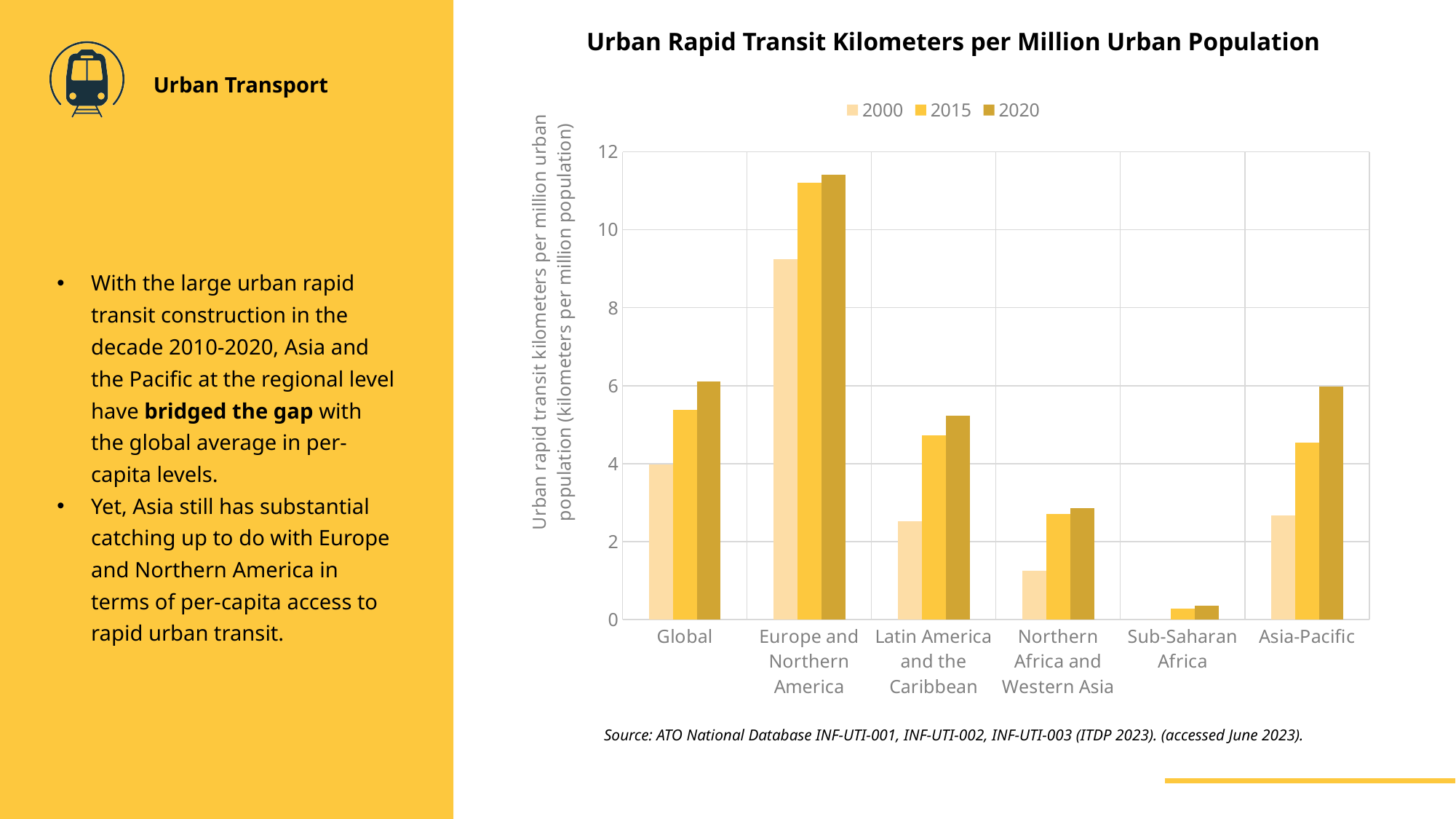
Which is larger in 2020: Asia-Pacific or Latin America and the Caribbean? Asia-Pacific Which is larger in 2000: Global or Asia-Pacific? Global Is the 2015 value for Asia-Pacific greater or less than 4? greater Is the 2020 value for Europe and Northern America greater or less than 10? greater Is the 2020 value for Northern Africa and Western Asia greater or less than 4? less What kind of chart is shown on the slide? bar chart Which region has the lowest value for 2020? Sub-Saharan Africa How many regions (categories) are shown on the x axis? 6 How many series does the legend list? 3 What years are listed in the chart legend? 2000, 2015, 2020 Which region has the highest value for 2020? Europe and Northern America Do the values for Asia-Pacific rise or fall from 2000 to 2020? rise